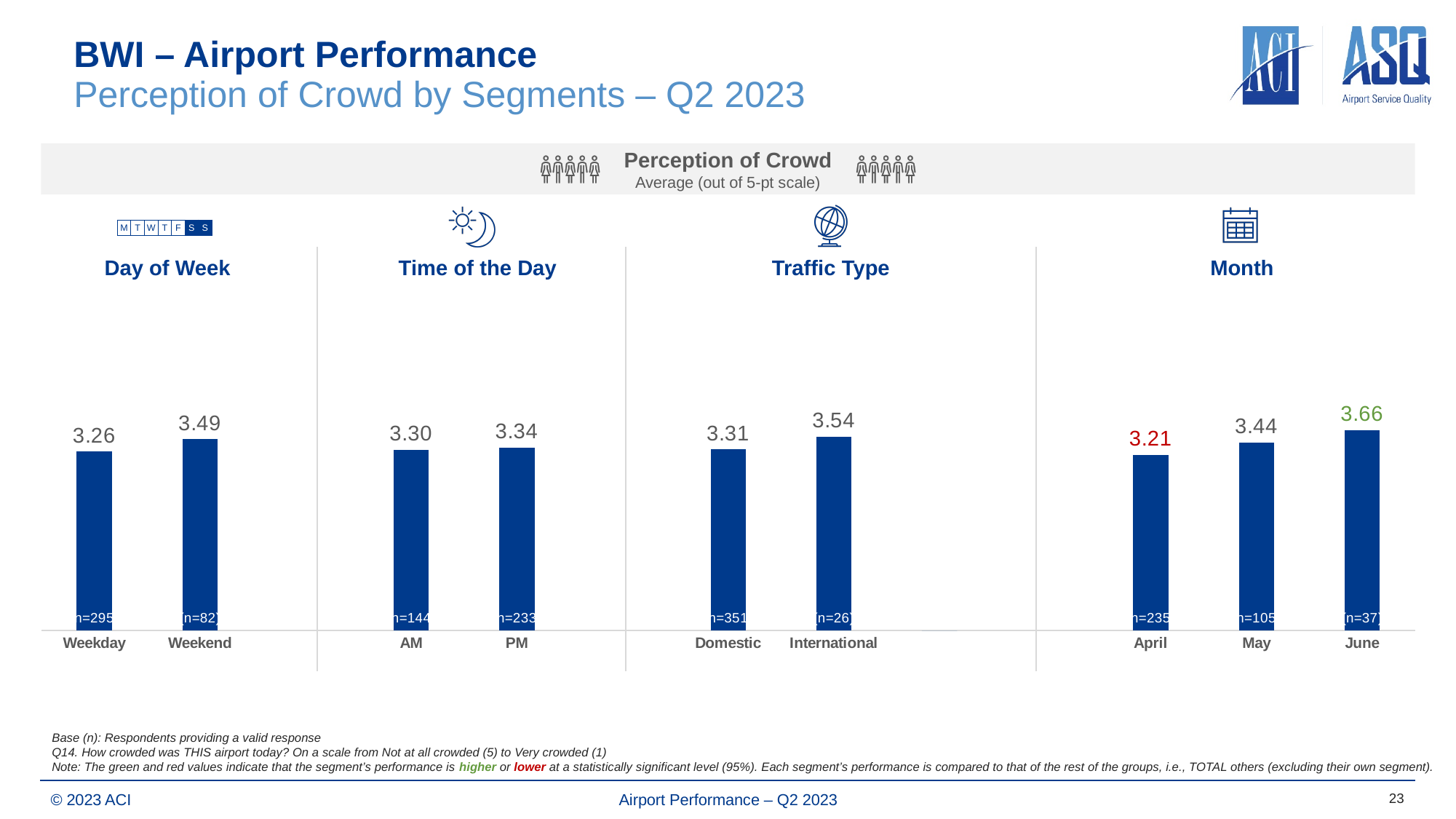
What kind of chart is used in the Time of the Day panel? Bar chart In the Month chart, do the values rise or fall from April to June? Rise In the Month chart, what is the value for April? 3.21 In the Traffic Type chart, what is the value for International? 3.54 In the Traffic Type chart, which is larger, Domestic or International? International In the Month chart, how many months are shown? 3 In the Traffic Type chart, what is the base (n) for the Domestic segment? n=351 In the Time of the Day chart, what is the value for AM? 3.30 In the Day of Week chart, what is the value for Weekend? 3.49 In the Month chart, which month has the highest value? June In the Month chart, which month has the lowest value? April In the Day of Week chart, what is the difference between the Weekend and Weekday values? 0.23